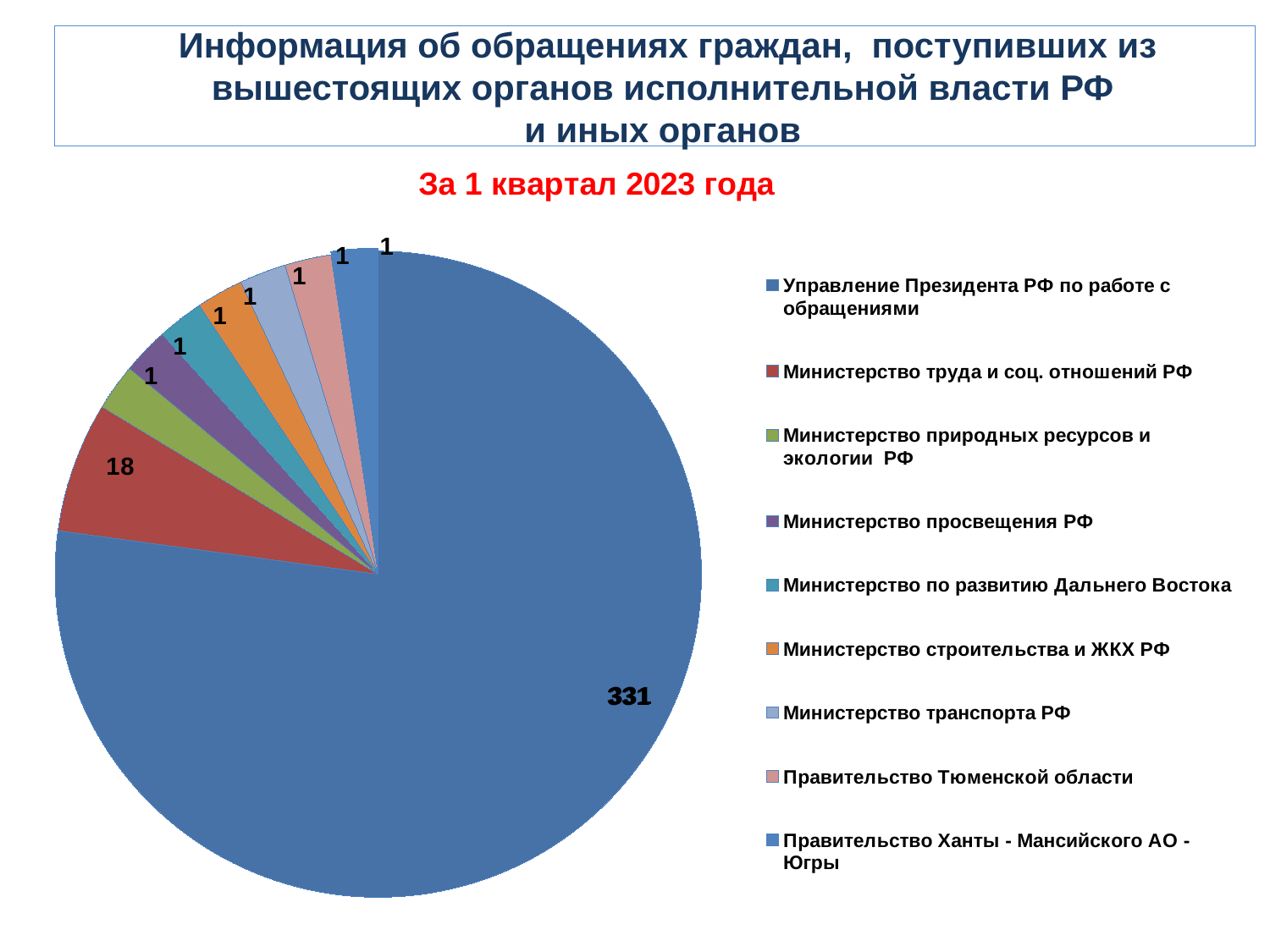
What is the value for Министерство транспорта РФ? 1 What period does the chart cover, according to the red subtitle? За 1 квартал 2023 года How many slices does the pie chart have? 9 What is the value for Министерство труда и соц. отношений РФ? 18 What colour is the slice for Министерство природных ресурсов и экологии РФ? green What kind of chart is shown on the slide? pie chart What is the total of all the values shown in the pie chart? 356 What is the value for Управление Президента РФ по работе с обращениями? 331 Which category has the largest slice of the pie? Управление Президента РФ по работе с обращениями Which is larger: the value for Министерство труда и соц. отношений РФ or the value for Правительство Тюменской области? Министерство труда и соц. отношений РФ What is the difference between the values for Управление Президента РФ по работе с обращениями and Министерство труда и соц. отношений РФ? 313 How many entries does the legend list? 9